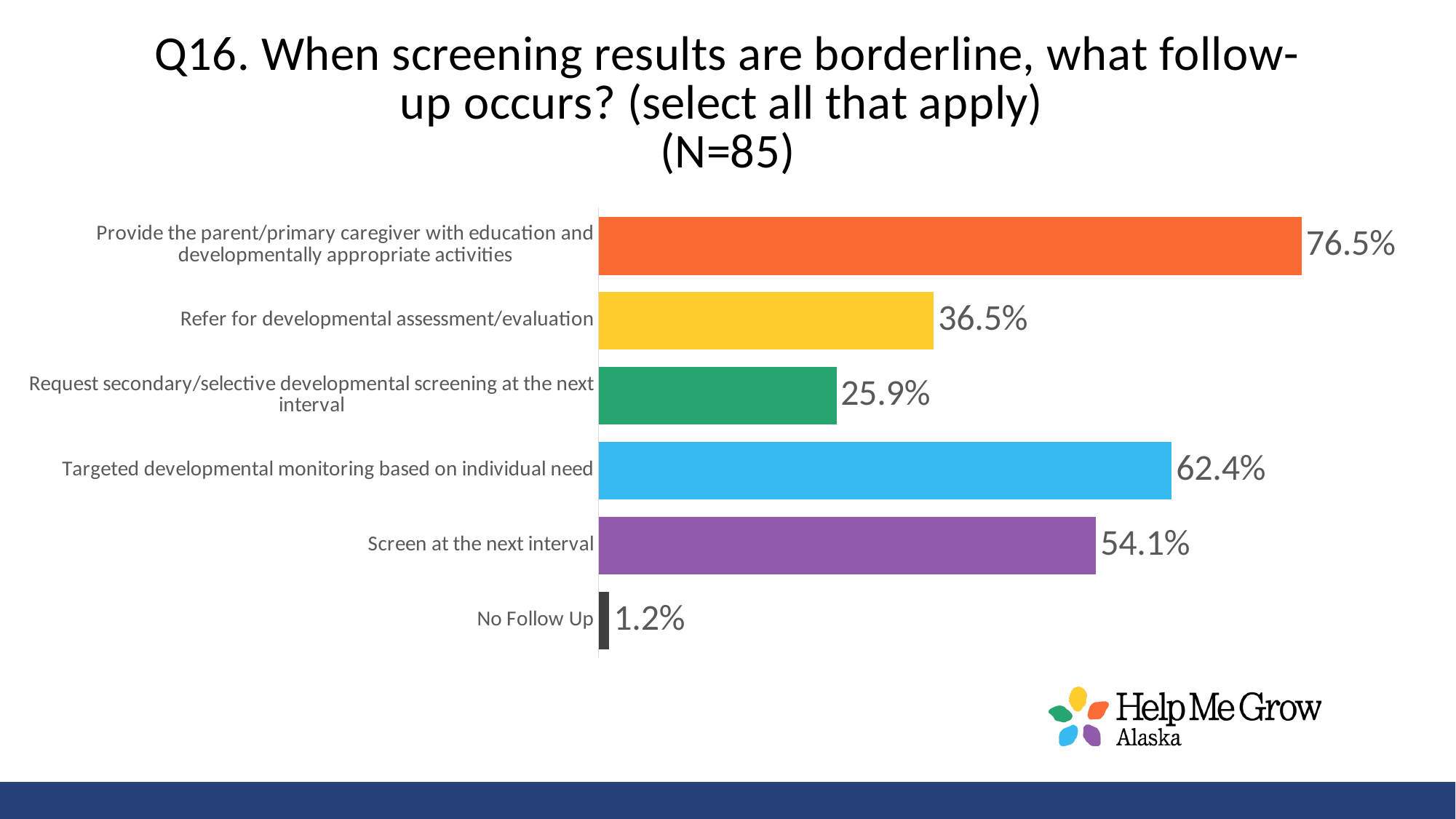
How many follow-up categories are shown in the chart? 6 What colour is the bar for "Screen at the next interval"? Purple Which is larger: the value for "Refer for developmental assessment/evaluation" or for "Request secondary/selective developmental screening at the next interval"? Refer for developmental assessment/evaluation What is the value for "Targeted developmental monitoring based on individual need"? 62.4% What is the sample size (N) stated in the chart title? 85 What is the value shown for "Screen at the next interval"? 54.1% What is the difference in percentage points between "Provide the parent/primary caregiver with education and developmentally appropriate activities" and "Targeted developmental monitoring based on individual need"? 14.1 Which category has the lowest percentage? No Follow Up What percentage of respondents selected "Refer for developmental assessment/evaluation"? 36.5% What type of chart is shown on the slide? Bar chart Which follow-up option has the highest percentage? Provide the parent/primary caregiver with education and developmentally appropriate activities What percentage is shown for "No Follow Up"? 1.2%